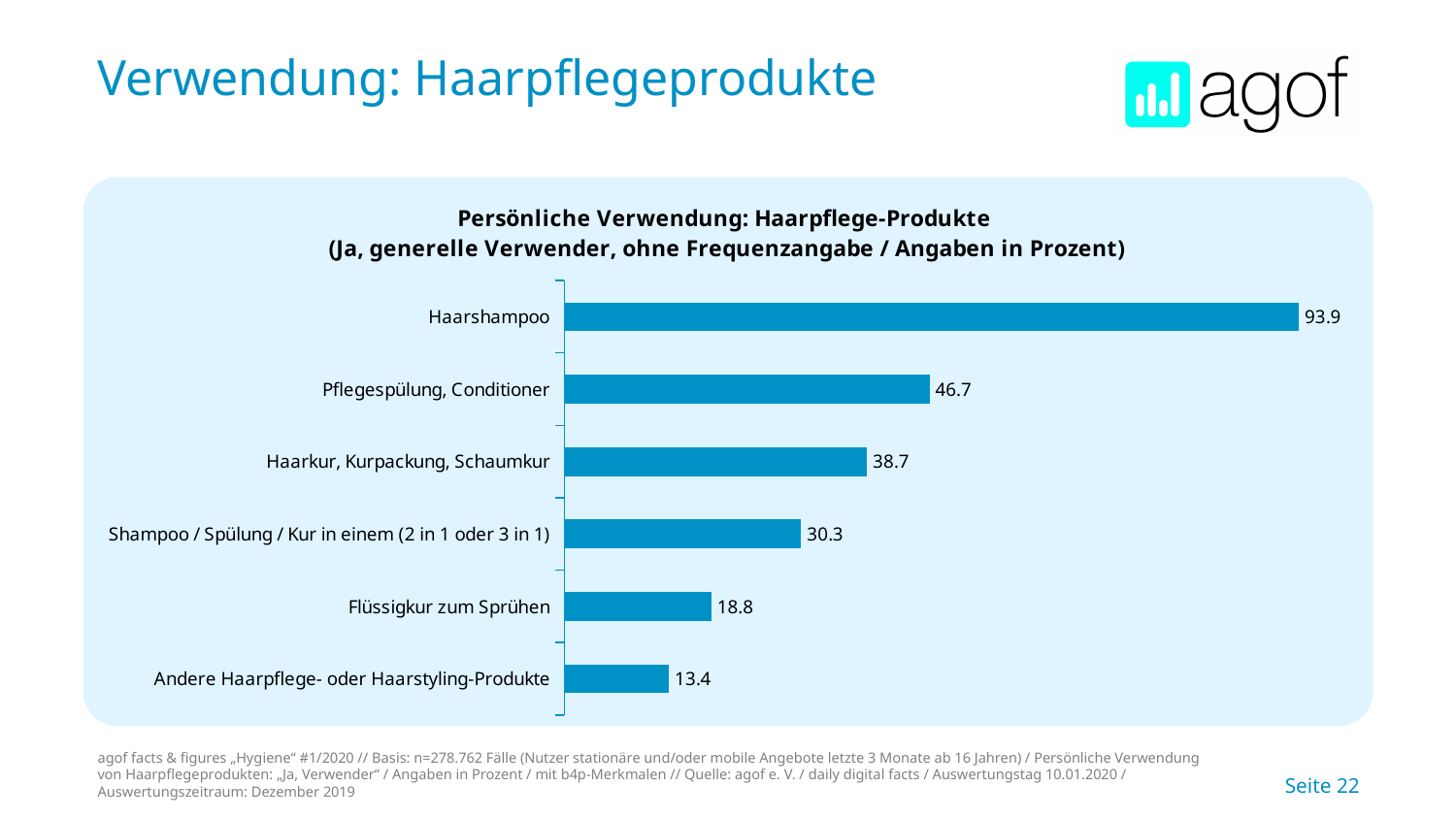
What is the value for Pflegespülung, Conditioner? 46.7 What is the title of the chart? Persönliche Verwendung: Haarpflege-Produkte (Ja, generelle Verwender, ohne Frequenzangabe / Angaben in Prozent) What is the difference between the values for Haarkur, Kurpackung, Schaumkur and Shampoo / Spülung / Kur in einem (2 in 1 oder 3 in 1)? 8.4 What is the value for Flüssigkur zum Sprühen? 18.8 Which category has the highest value? Haarshampoo How many categories are shown in the chart? 6 Which is larger, the value for Flüssigkur zum Sprühen or the value for Andere Haarpflege- oder Haarstyling-Produkte? Flüssigkur zum Sprühen Which category has the lowest value? Andere Haarpflege- oder Haarstyling-Produkte What kind of chart is shown on the slide? Bar chart What is the value for Haarshampoo? 93.9 What is the difference between the values for Haarshampoo and Pflegespülung, Conditioner? 47.2 What is the value for Shampoo / Spülung / Kur in einem (2 in 1 oder 3 in 1)? 30.3